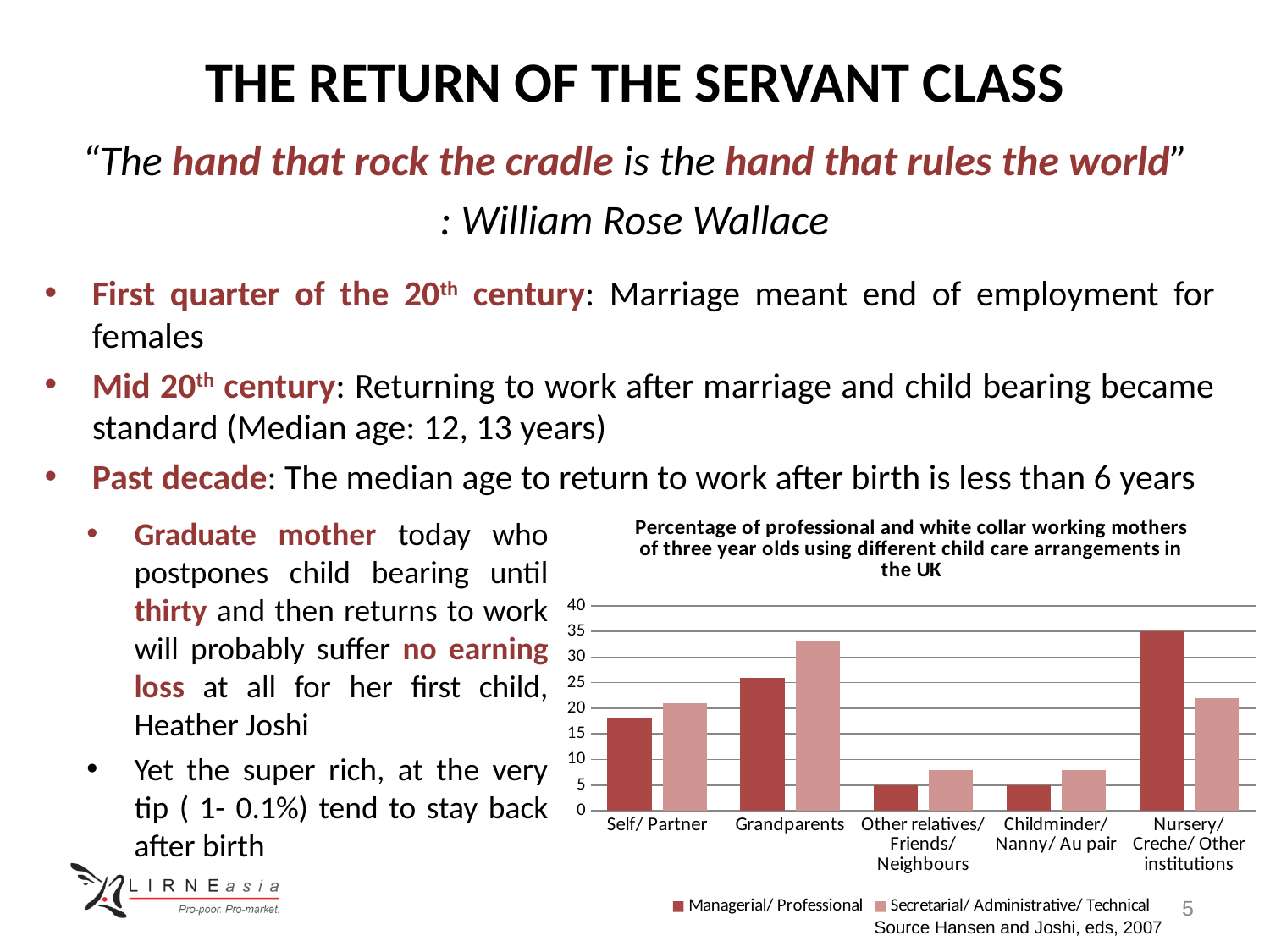
Is the Secretarial/ Administrative/ Technical value for Nursery/ Creche/ Other institutions greater or less than 25? less Which child care arrangement has the highest value for the Managerial/ Professional series? Nursery/ Creche/ Other institutions Is the Secretarial/ Administrative/ Technical value for Grandparents greater or less than 30? greater For Nursery/ Creche/ Other institutions, which series has the larger value: Managerial/ Professional or Secretarial/ Administrative/ Technical? Managerial/ Professional Which child care arrangement has the highest value for the Secretarial/ Administrative/ Technical series? Grandparents What kind of chart is shown on the slide? bar chart How many child care arrangement categories are shown on the x axis of the chart? 5 How many series does the chart's legend list? 2 Is the Secretarial/ Administrative/ Technical value for Other relatives/ Friends/ Neighbours greater or less than 10? less Which series is shown in the darker red colour in the chart's legend? Managerial/ Professional For Grandparents, which series has the larger value: Managerial/ Professional or Secretarial/ Administrative/ Technical? Secretarial/ Administrative/ Technical